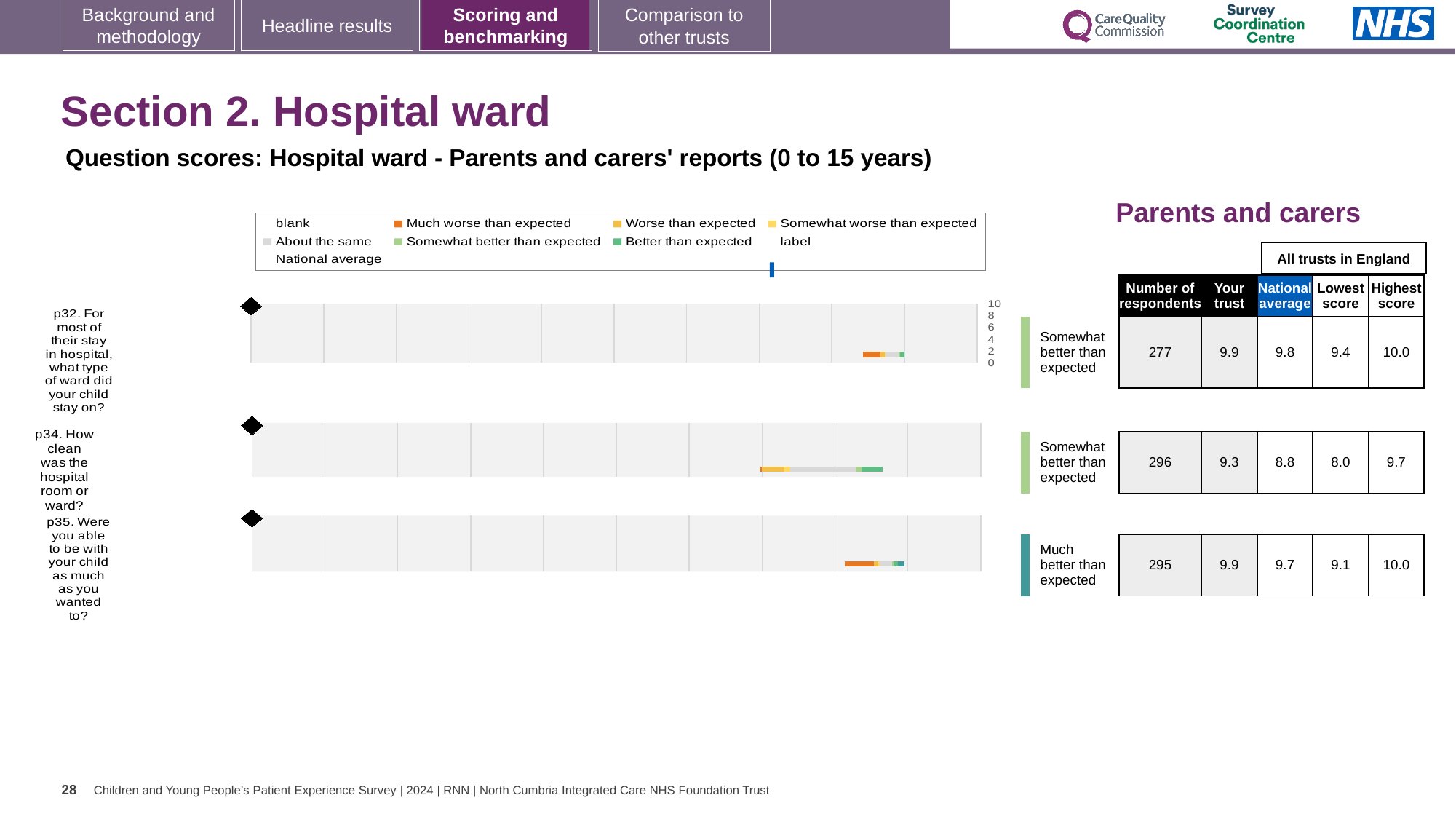
What is the difference between the 'Your trust' score and the national average for p34? 0.5 How many respondents answered p35 (Were you able to be with your child as much as you wanted to)? 295 What is the highest score among all trusts in England for p32? 10.0 What is the 'Your trust' score for p34 (How clean was the hospital room or ward?)? 9.3 What benchmark category is shown for p35 (Were you able to be with your child as much as you wanted to)? Much better than expected Which question has the highest number of respondents? p34 What is the national average score for p32 (what type of ward did your child stay on)? 9.8 What is the lowest score among all trusts in England for p34? 8.0 Which question has the lowest 'Your trust' score? p34 What kind of chart is used to show the question scores on this slide? Bar chart For p35, is the 'Your trust' score or the national average higher? Your trust How many questions (p32, p34, p35) are plotted on the slide? 3